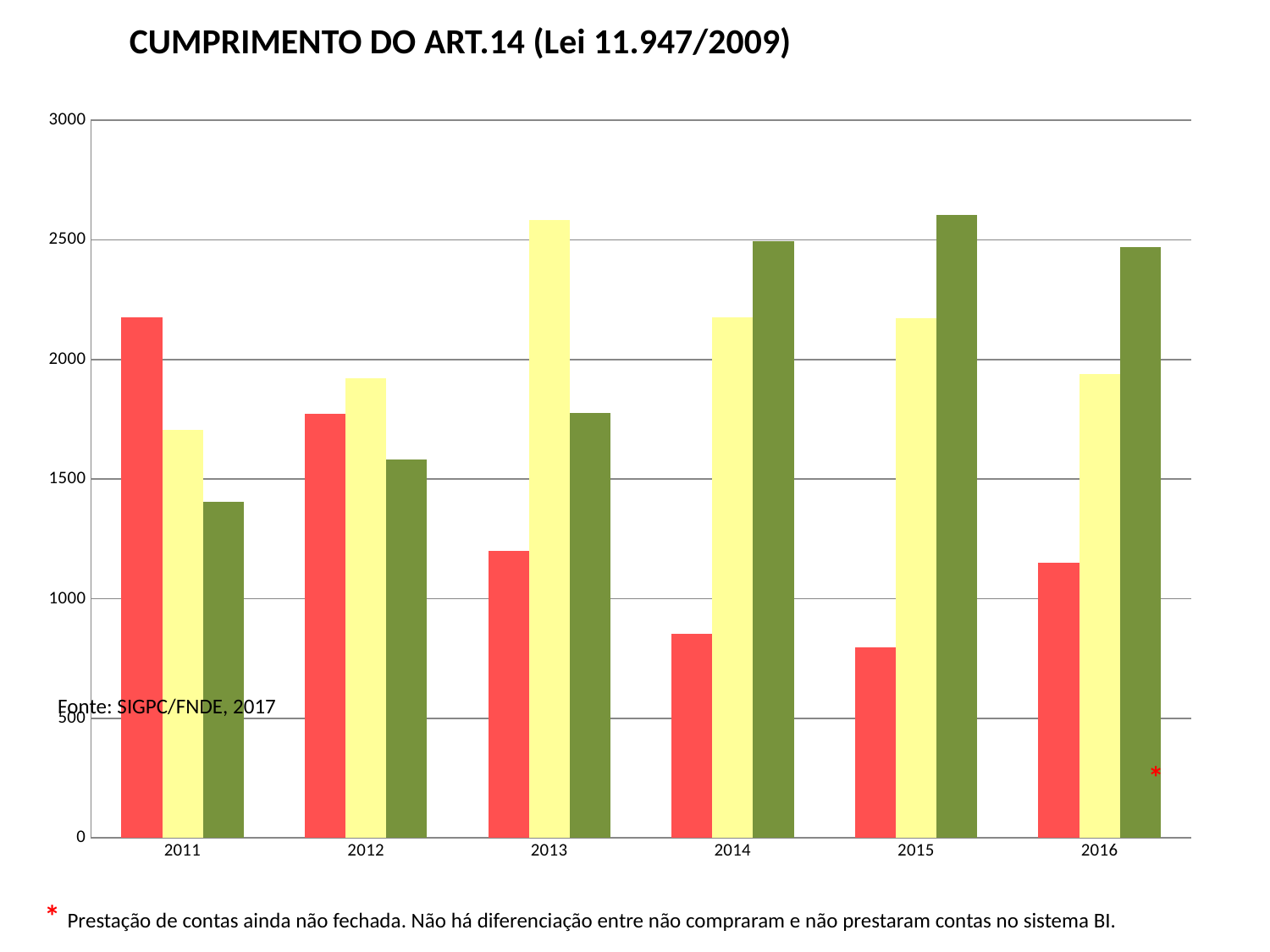
In which year is the yellow bar the highest? 2013 In which year is the red bar the highest? 2011 What is the title of the chart? CUMPRIMENTO DO ART.14 (Lei 11.947/2009) Is the value of the red bar for 2011 greater or less than 2000? greater Is the value of the red bar for 2015 greater or less than 1000? less For 2014, which is larger, the red bar or the green bar? the green bar How many years are shown on the x axis of the chart? 6 Is the value of the yellow bar for 2013 greater or less than 2500? greater What kind of chart is shown on the slide? bar chart How many bars are plotted for each year in the chart? 3 In which year is the green bar the lowest? 2011